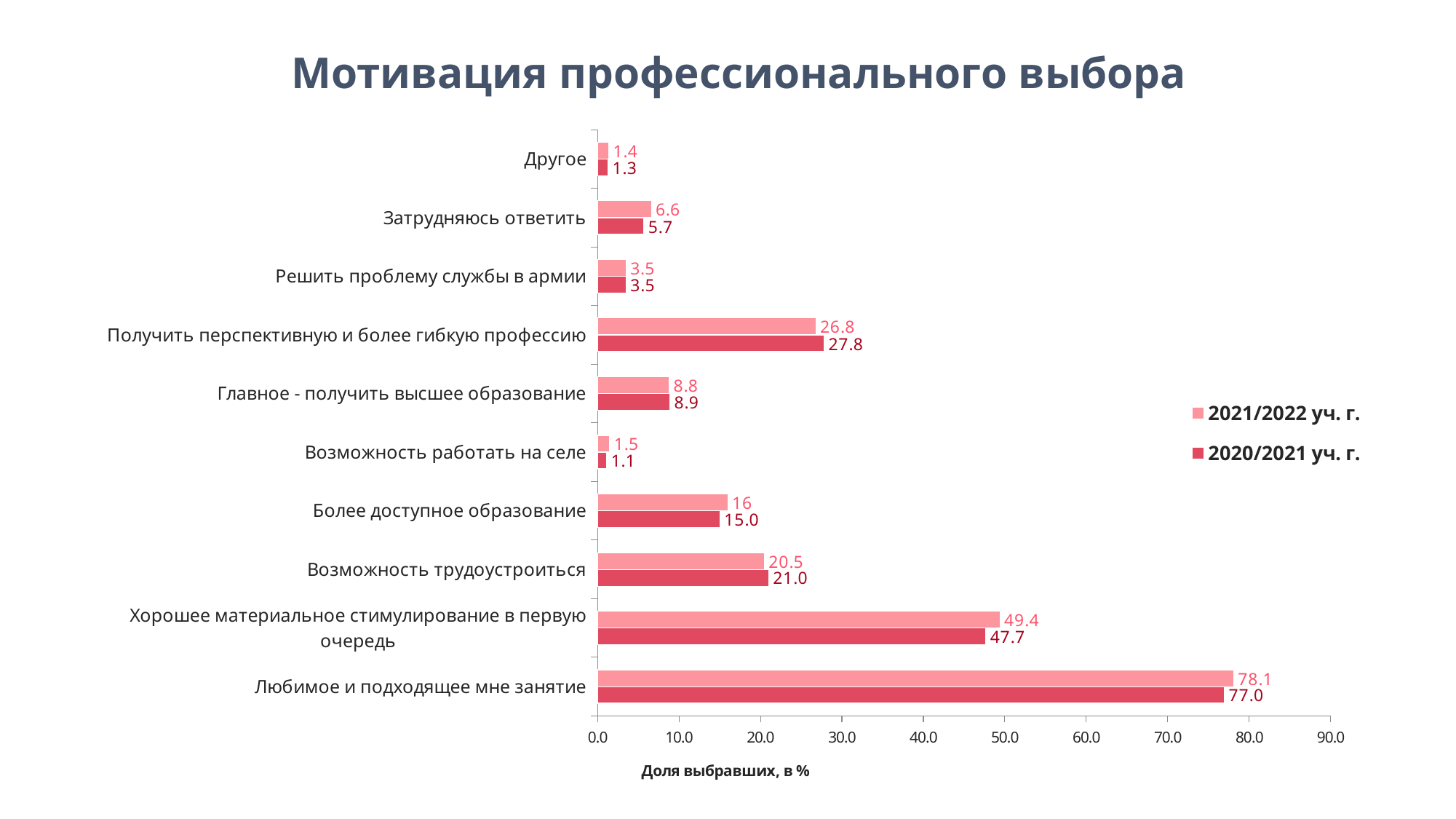
For "Получить перспективную и более гибкую профессию", which series has the larger value: 2021/2022 уч. г. or 2020/2021 уч. г.? 2020/2021 уч. г. What is the value for "Возможность трудоустроиться" in the 2021/2022 уч. г. series? 20.5 What is the value for "Хорошее материальное стимулирование в первую очередь" in the 2020/2021 уч. г. series? 47.7 What is the title of the chart? Мотивация профессионального выбора Which category has the highest value in the 2020/2021 уч. г. series? Любимое и подходящее мне занятие What is the difference between the 2021/2022 уч. г. and 2020/2021 уч. г. values for "Затрудняюсь ответить"? 0.9 How many categories are shown on the chart? 10 How many series does the legend list? 2 What is the value for "Любимое и подходящее мне занятие" in the 2021/2022 уч. г. series? 78.1 What type of chart is shown on the slide? bar chart Which category has the lowest value in the 2020/2021 уч. г. series? Возможность работать на селе Is the 2021/2022 уч. г. value for "Хорошее материальное стимулирование в первую очередь" greater or less than 40.0? greater